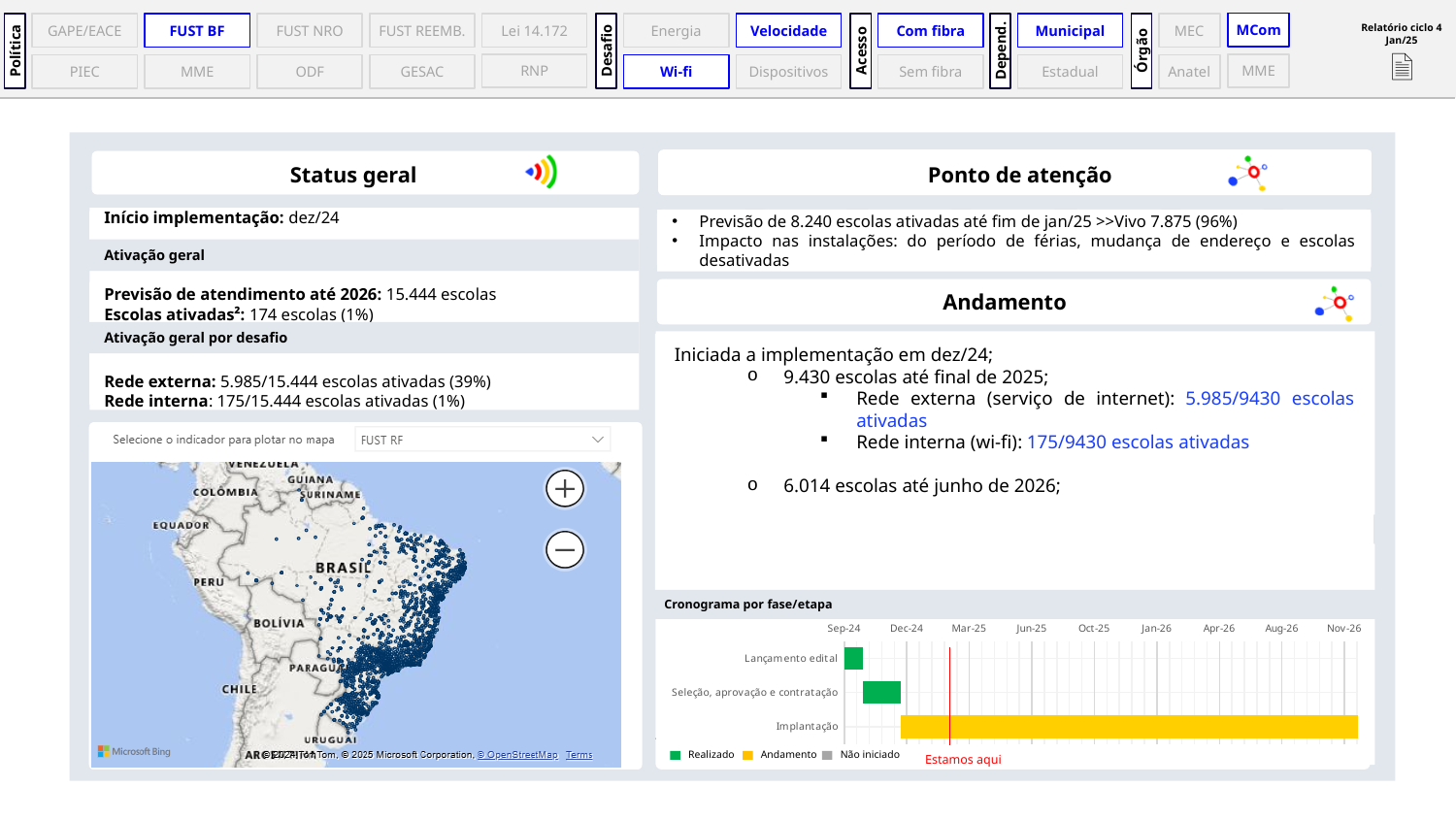
How many phases are listed on the y axis of the 'Cronograma por fase/etapa' chart? 3 In the 'Cronograma por fase/etapa' chart, which phase starts earliest? Lançamento edital What kind of chart is the 'Cronograma por fase/etapa' chart? Bar chart (Gantt-style horizontal bars) What label is written under the red vertical line in the 'Cronograma por fase/etapa' chart? Estamos aqui How many entries does the legend of the 'Cronograma por fase/etapa' chart list? 3 In the 'Cronograma por fase/etapa' chart, which phase has the shortest bar? Lançamento edital In the 'Cronograma por fase/etapa' chart, which bar is longer: 'Seleção, aprovação e contratação' or 'Implantação'? Implantação In the 'Cronograma por fase/etapa' chart, what colour represents 'Realizado' in the legend? Green In the 'Cronograma por fase/etapa' chart, which phase is shown with the 'Andamento' status? Implantação In the 'Cronograma por fase/etapa' chart, which phase has the longest bar? Implantação In the 'Cronograma por fase/etapa' chart, which phase ends latest? Implantação In the 'Cronograma por fase/etapa' chart, which phases are shown with the 'Realizado' status? Lançamento edital and Seleção, aprovação e contratação